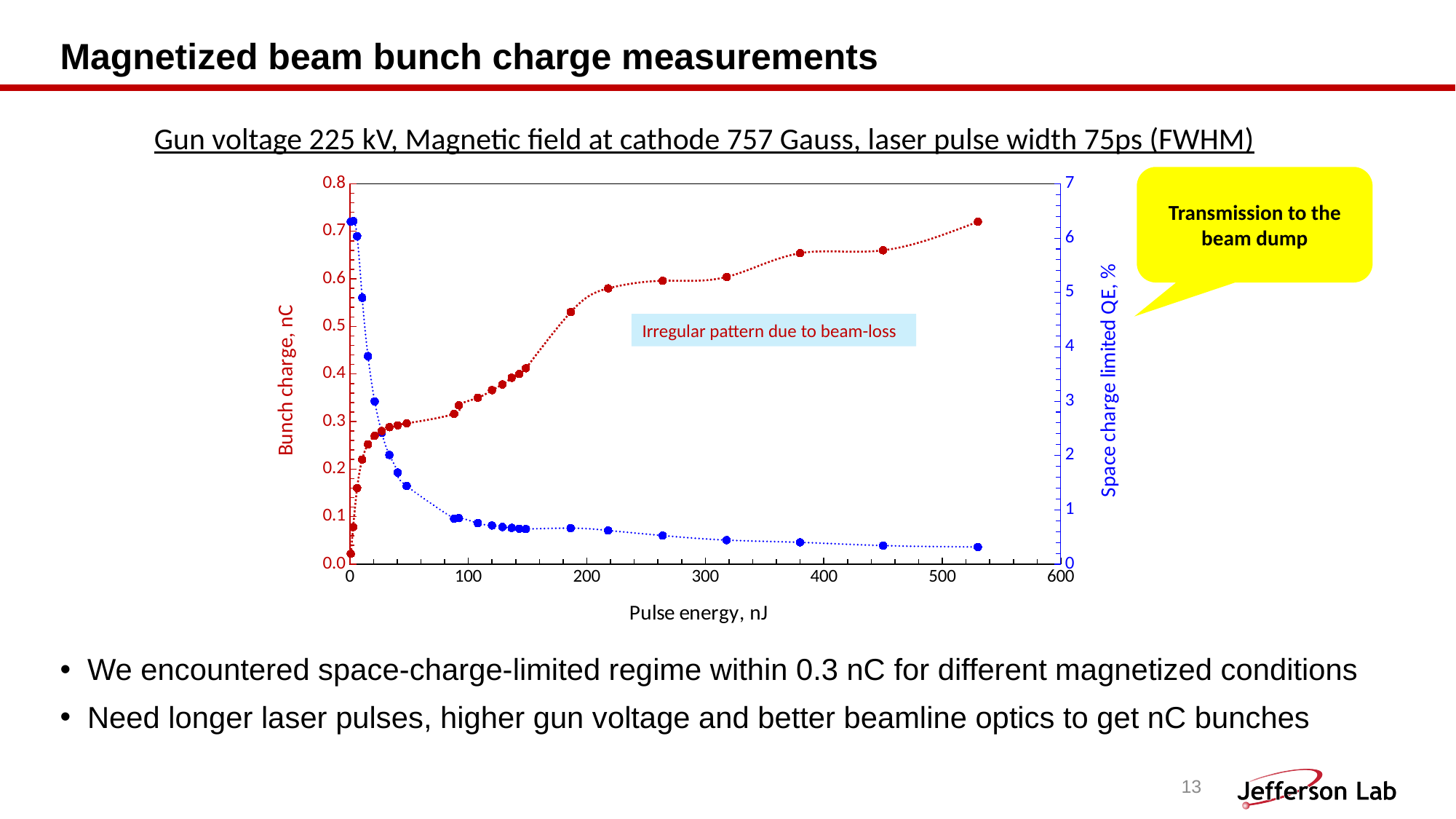
What is the title of the x axis of the chart? Pulse energy, nJ Is the space charge limited QE at the highest pulse energy (about 530 nJ) greater or less than 1%? less What is the title of the right-hand y axis of the chart? Space charge limited QE, % What does the annotation box inside the plot area say? Irregular pattern due to beam-loss Does the space charge limited QE (blue series) rise or fall as pulse energy increases? Fall Is the space charge limited QE at a pulse energy of about 100 nJ greater or less than 2%? less Is the bunch charge at a pulse energy of about 100 nJ greater or less than 0.2 nC? greater What kind of chart is shown on the slide? Scatter (line) chart Does the bunch charge (red series) rise or fall as pulse energy increases? Rise How many data series are plotted on the chart? 2